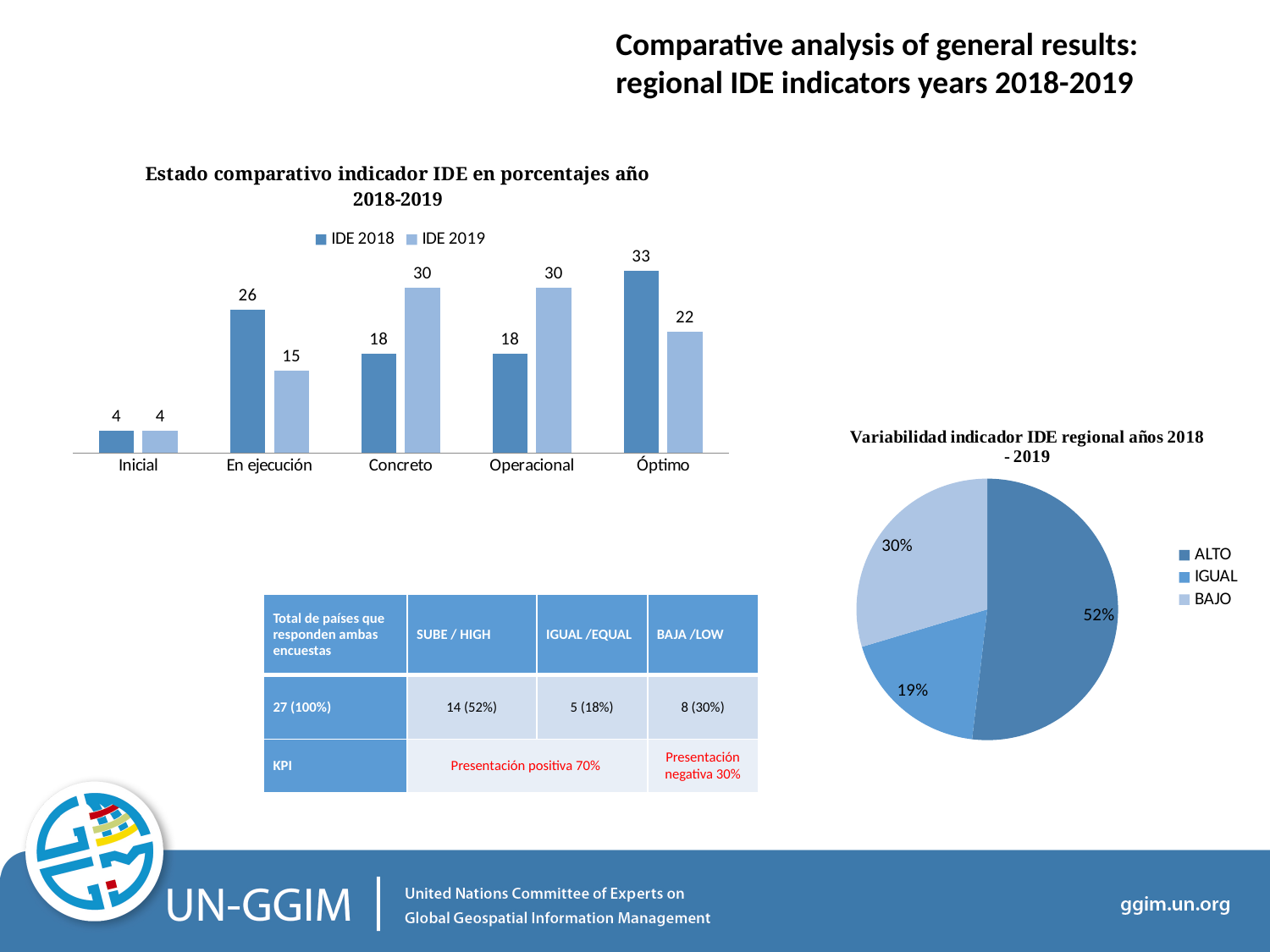
In the pie chart 'Variabilidad indicador IDE regional años 2018 - 2019', what is the difference between the ALTO and IGUAL shares? 33% How many categories are shown on the x axis of the bar chart 'Estado comparativo indicador IDE en porcentajes año 2018-2019'? 5 How many series does the legend of the bar chart 'Estado comparativo indicador IDE en porcentajes año 2018-2019' list? 2 In the pie chart 'Variabilidad indicador IDE regional años 2018 - 2019', what share does BAJO have? 30% What kind of chart is 'Variabilidad indicador IDE regional años 2018 - 2019'? Pie chart In the bar chart 'Estado comparativo indicador IDE en porcentajes año 2018-2019', what is the IDE 2019 value for En ejecución? 15 In the bar chart 'Estado comparativo indicador IDE en porcentajes año 2018-2019', which category has the lowest IDE 2019 value? Inicial In the bar chart 'Estado comparativo indicador IDE en porcentajes año 2018-2019', what is the difference between the IDE 2019 and IDE 2018 values for Concreto? 12 In the bar chart 'Estado comparativo indicador IDE en porcentajes año 2018-2019', which is larger for Óptimo: IDE 2018 or IDE 2019? IDE 2018 In the bar chart 'Estado comparativo indicador IDE en porcentajes año 2018-2019', what is the IDE 2018 value for Óptimo? 33 In the pie chart 'Variabilidad indicador IDE regional años 2018 - 2019', which slice is the largest? ALTO In the bar chart 'Estado comparativo indicador IDE en porcentajes año 2018-2019', which category has the highest IDE 2018 value? Óptimo